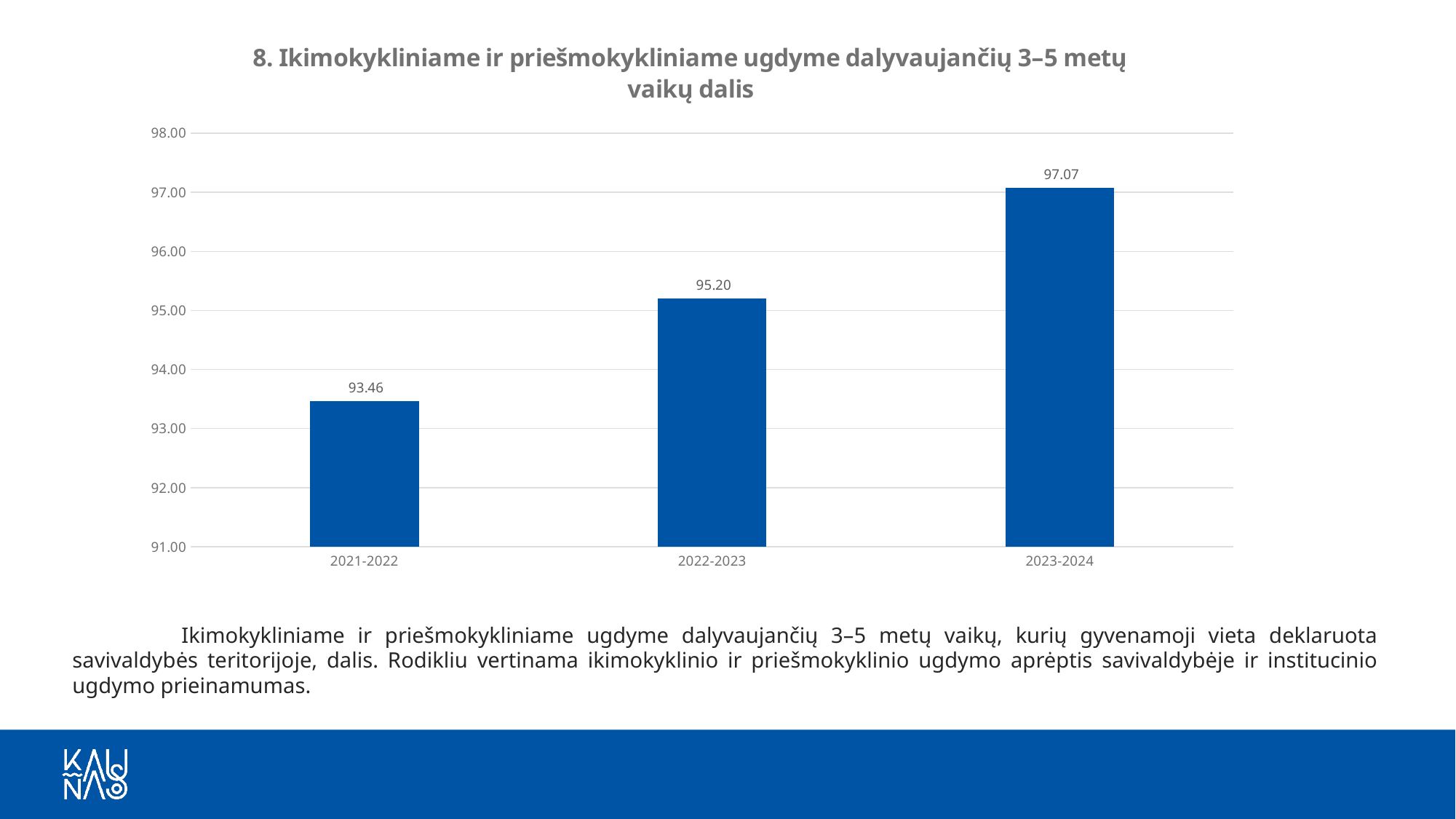
Which period has the lowest value? 2021-2022 What is the value for 2021-2022? 93.46 What is the difference between the values for 2022-2023 and 2021-2022? 1.74 Which period has the highest value? 2023-2024 Which is larger, the value for 2022-2023 or the value for 2023-2024? 2023-2024 What is the value for 2023-2024? 97.07 What is the difference between the values for 2023-2024 and 2021-2022? 3.61 What kind of chart is shown on the slide? bar chart What is the value for 2022-2023? 95.20 Is the value for 2022-2023 greater or less than 95.00? greater Do the values rise or fall from 2021-2022 to 2023-2024? rise How many periods are shown on the x axis? 3